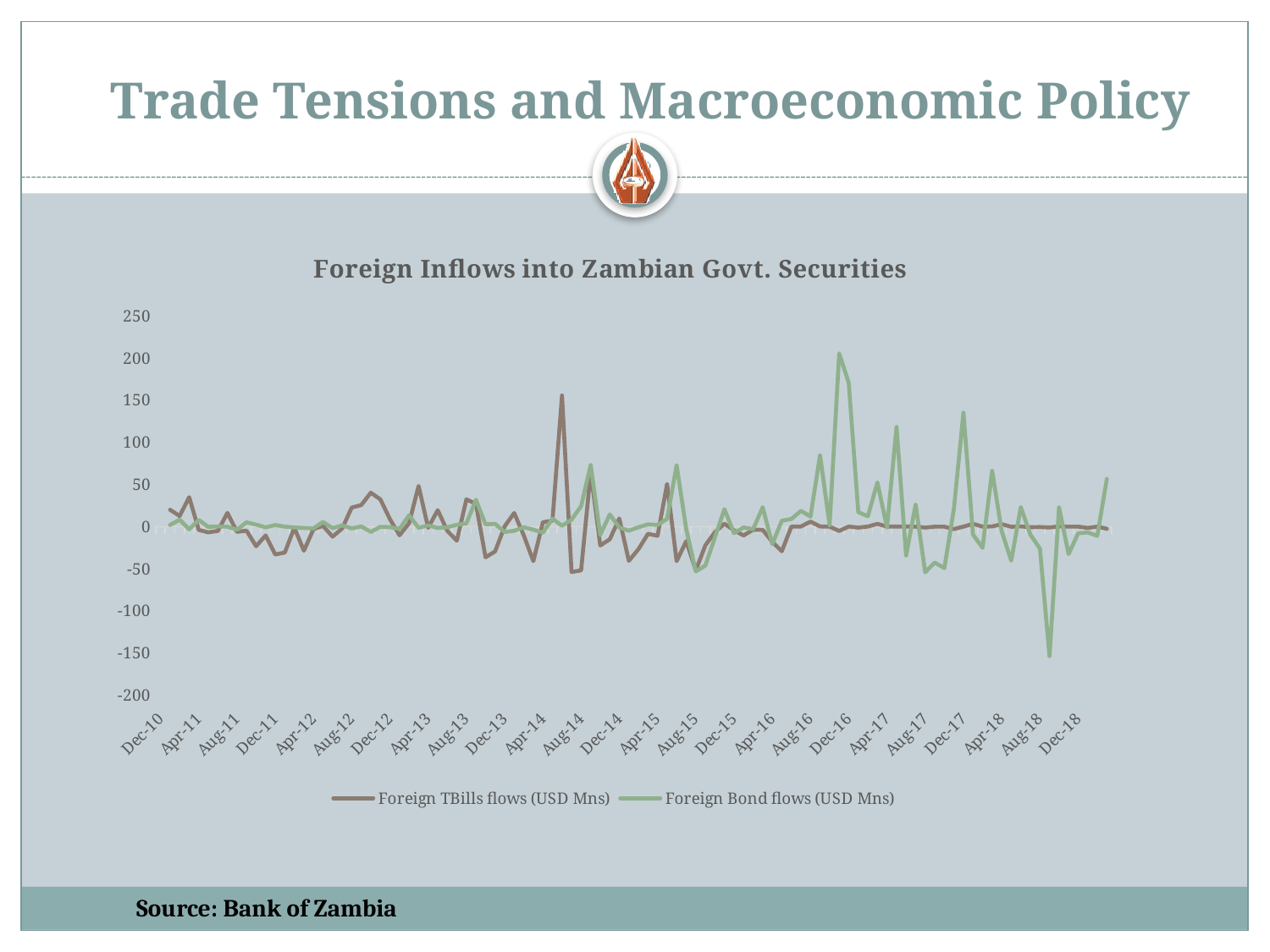
What kind of chart is shown on the slide? line chart Which series reaches the highest value on the chart? Foreign Bond flows (USD Mns) At the mid-2014 spike, which series has the higher value, Foreign TBills flows or Foreign Bond flows? Foreign TBills flows (USD Mns) Is the peak value of Foreign TBills flows (USD Mns) around mid-2014 greater or less than 100? greater What are the two series named in the legend? Foreign TBills flows (USD Mns) and Foreign Bond flows (USD Mns) Is the value of Foreign Bond flows (USD Mns) at its spike around Dec-17 greater or less than 100? greater Is the peak value of Foreign Bond flows (USD Mns) around Dec-16 greater or less than 150? greater What is the title of the chart? Foreign Inflows into Zambian Govt. Securities Around Dec-16, which series has the higher value, Foreign TBills flows or Foreign Bond flows? Foreign Bond flows (USD Mns) Which series reaches the lowest value on the chart? Foreign Bond flows (USD Mns) How many series does the legend list? 2